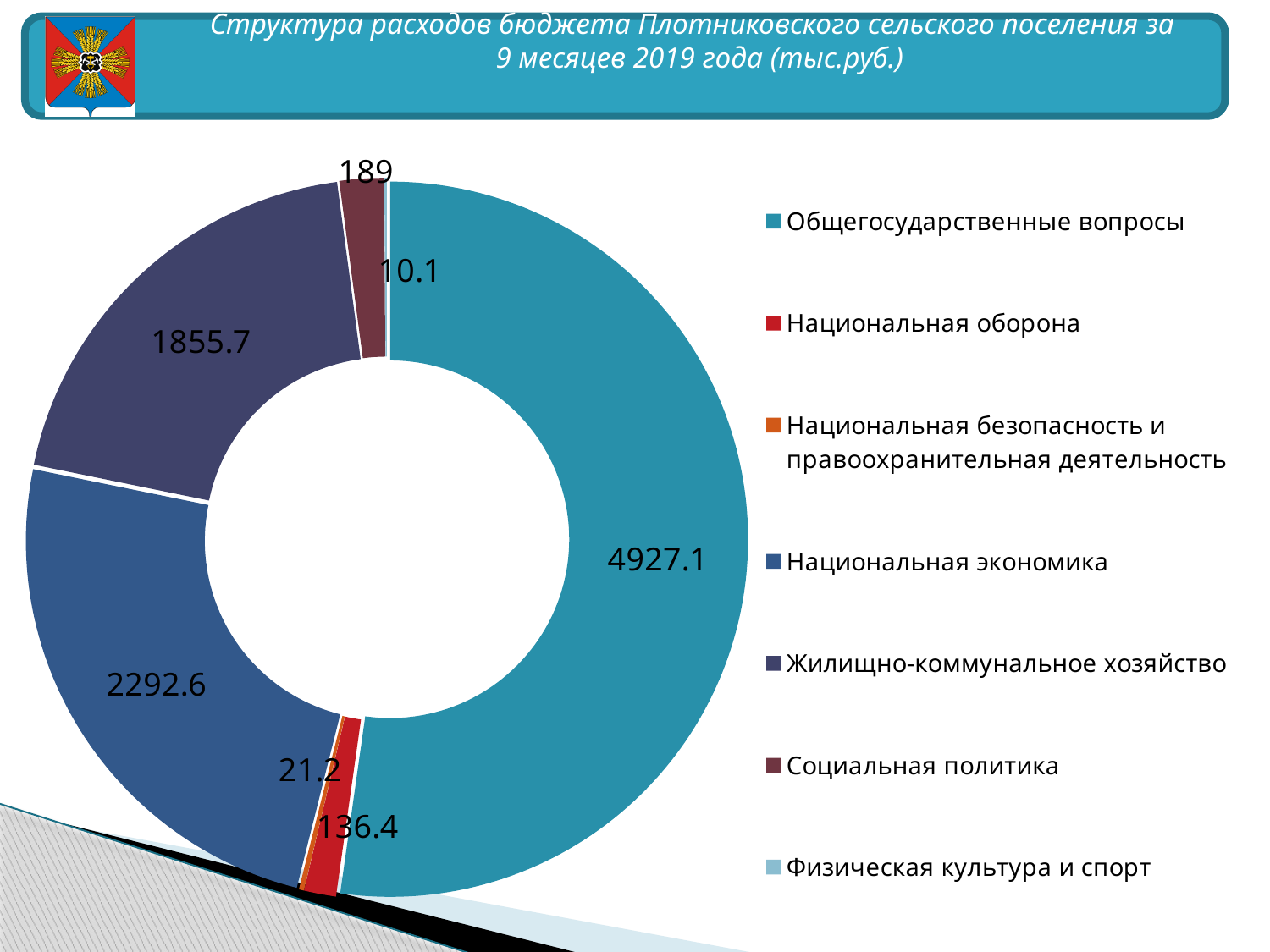
What is the value for Физическая культура и спорт? 10.1 What is the difference between Национальная экономика and Жилищно-коммунальное хозяйство? 436.9 What is the value for Национальная экономика? 2292.6 Which category has the lowest value? Физическая культура и спорт How many categories does the chart show? 7 What is the value for Жилищно-коммунальное хозяйство? 1855.7 What is the value for Общегосударственные вопросы? 4927.1 What kind of chart is shown on the slide? Pie (doughnut) chart What is the difference between Социальная политика and Национальная оборона? 52.6 Which category has the highest value? Общегосударственные вопросы Which is larger, Национальная оборона or Национальная безопасность и правоохранительная деятельность? Национальная оборона What is the value for Социальная политика? 189